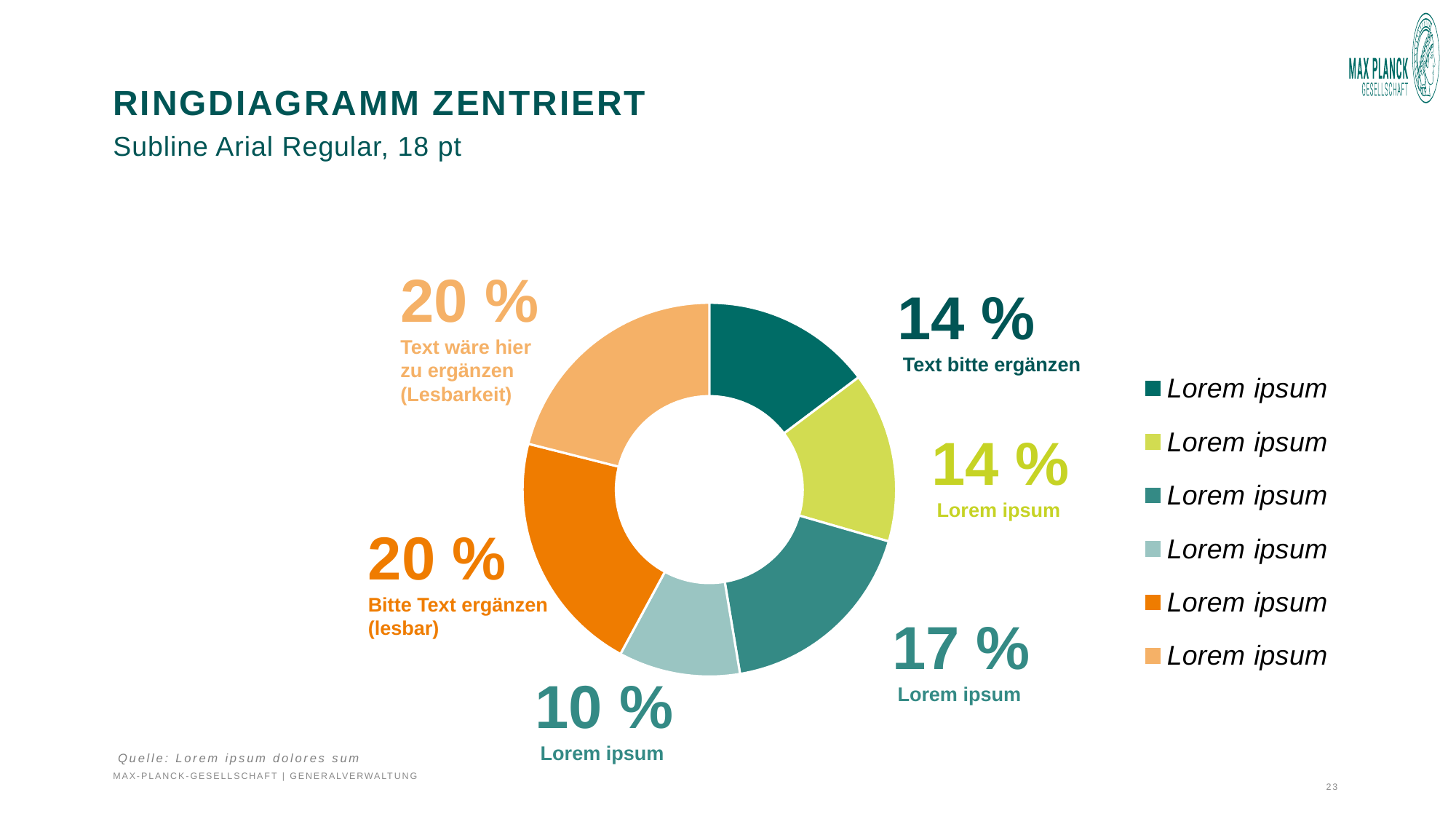
What is the value of the light teal slice at the bottom of the donut chart? 10 % What is the title of the slide containing the donut chart? RINGDIAGRAMM ZENTRIERT What is the difference between the 17 % slice and the 10 % slice? 7 % What is the smallest value shown on the donut chart? 10 % What is the largest value shown on the donut chart? 20 % What is the value of the light orange slice labelled "Text wäre hier zu ergänzen (Lesbarkeit)"? 20 % What is the value of the orange slice labelled "Bitte Text ergänzen (lesbar)"? 20 % How many entries does the legend list? 6 How many slices does the donut chart have? 6 What is the value of the dark teal slice labelled "Text bitte ergänzen"? 14 % What kind of chart is shown on the slide? Donut chart What is the value of the light green slice on the right of the donut chart? 14 %